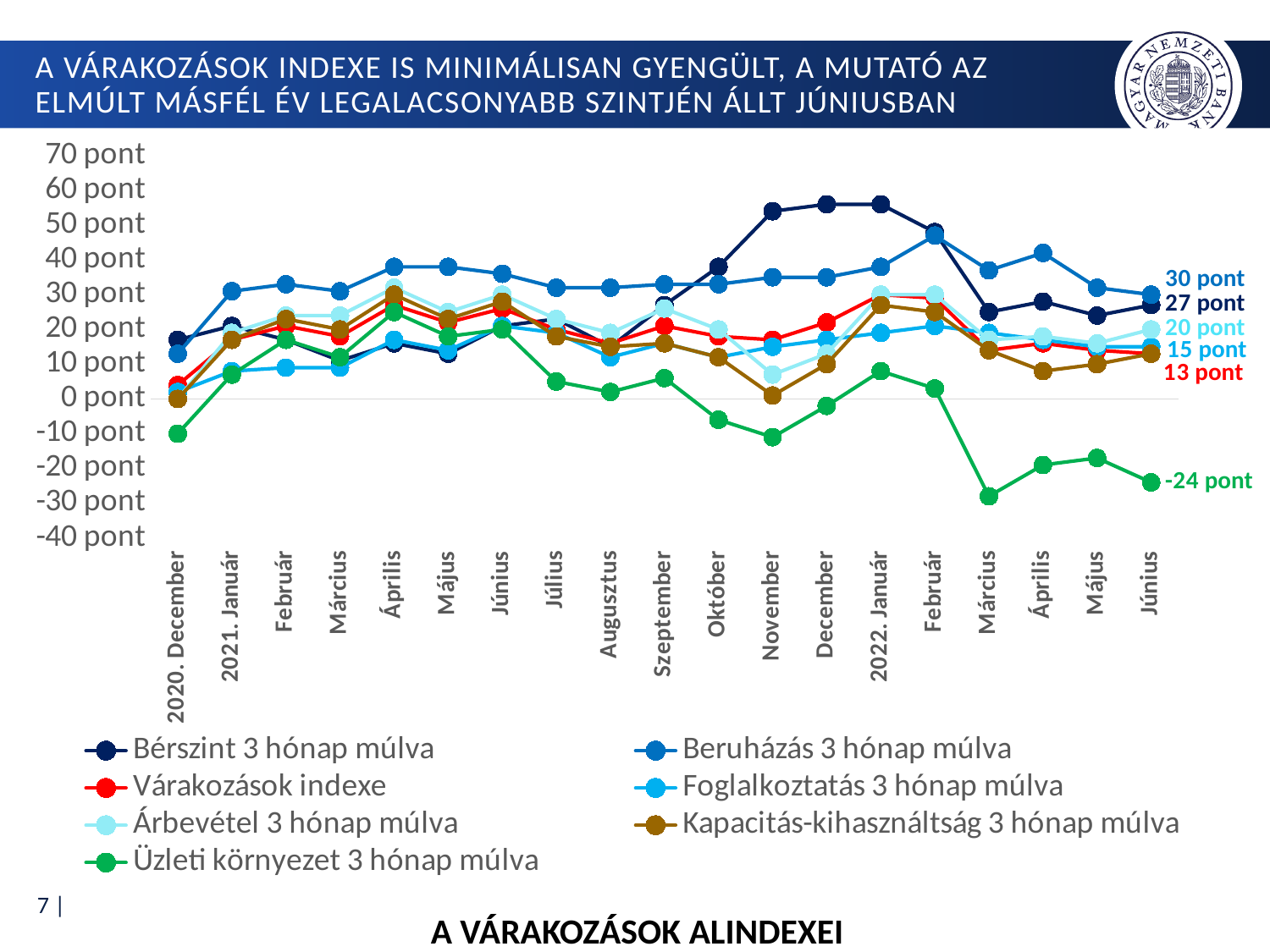
What is the value of Beruházás 3 hónap múlva in 2022 Június? 30 pont What is the title shown below the chart? A VÁRAKOZÁSOK ALINDEXEI What is the value of Várakozások indexe in 2022 Június? 13 pont What is the value of Bérszint 3 hónap múlva in 2022 Június? 27 pont How many series does the legend list? 7 Is the value for Bérszint 3 hónap múlva in 2021 November greater or less than 50 pont? greater What is the value of Üzleti környezet 3 hónap múlva in 2022 Június? -24 pont What kind of chart is shown on the slide? line chart Which is larger in 2022 Június: Árbevétel 3 hónap múlva or Foglalkoztatás 3 hónap múlva? Árbevétel 3 hónap múlva What is the difference between Beruházás 3 hónap múlva and Bérszint 3 hónap múlva in 2022 Június? 3 pont Is the value for Üzleti környezet 3 hónap múlva in 2022 Március greater or less than -20 pont? less Which series has the lowest value in 2022 Június? Üzleti környezet 3 hónap múlva